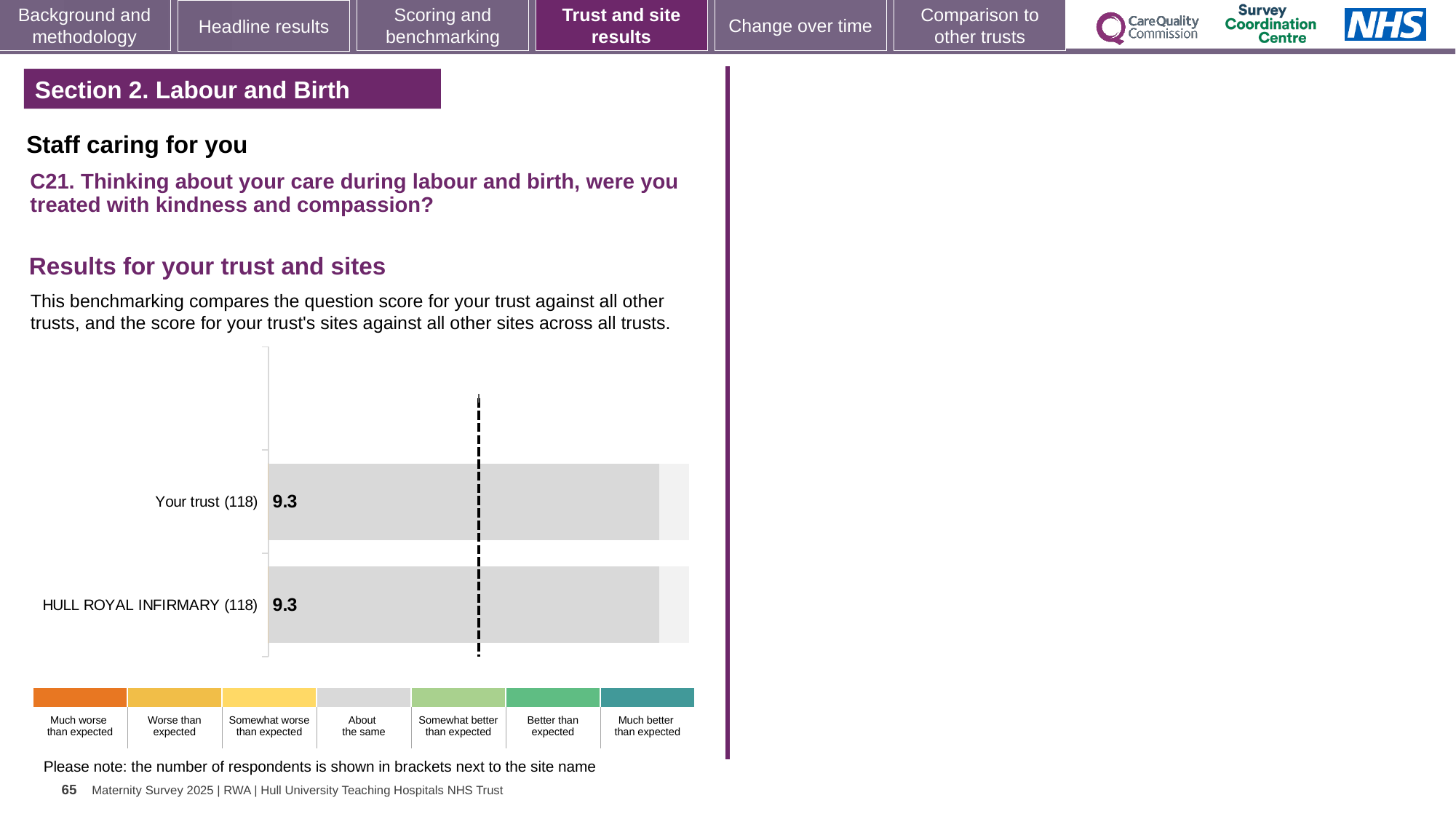
How many bars are plotted on the chart? 2 How many categories does the colour key below the chart list? 7 How many respondents are shown in brackets next to Your trust? 118 What is the difference between the score for Your trust and the score for HULL ROYAL INFIRMARY? 0 What kind of chart is shown on the slide? Bar chart Which category in the colour key does the grey colour of the bars correspond to? About the same How many respondents are shown in brackets next to HULL ROYAL INFIRMARY? 118 What is the score for HULL ROYAL INFIRMARY on the chart? 9.3 What is the score for Your trust on the chart? 9.3